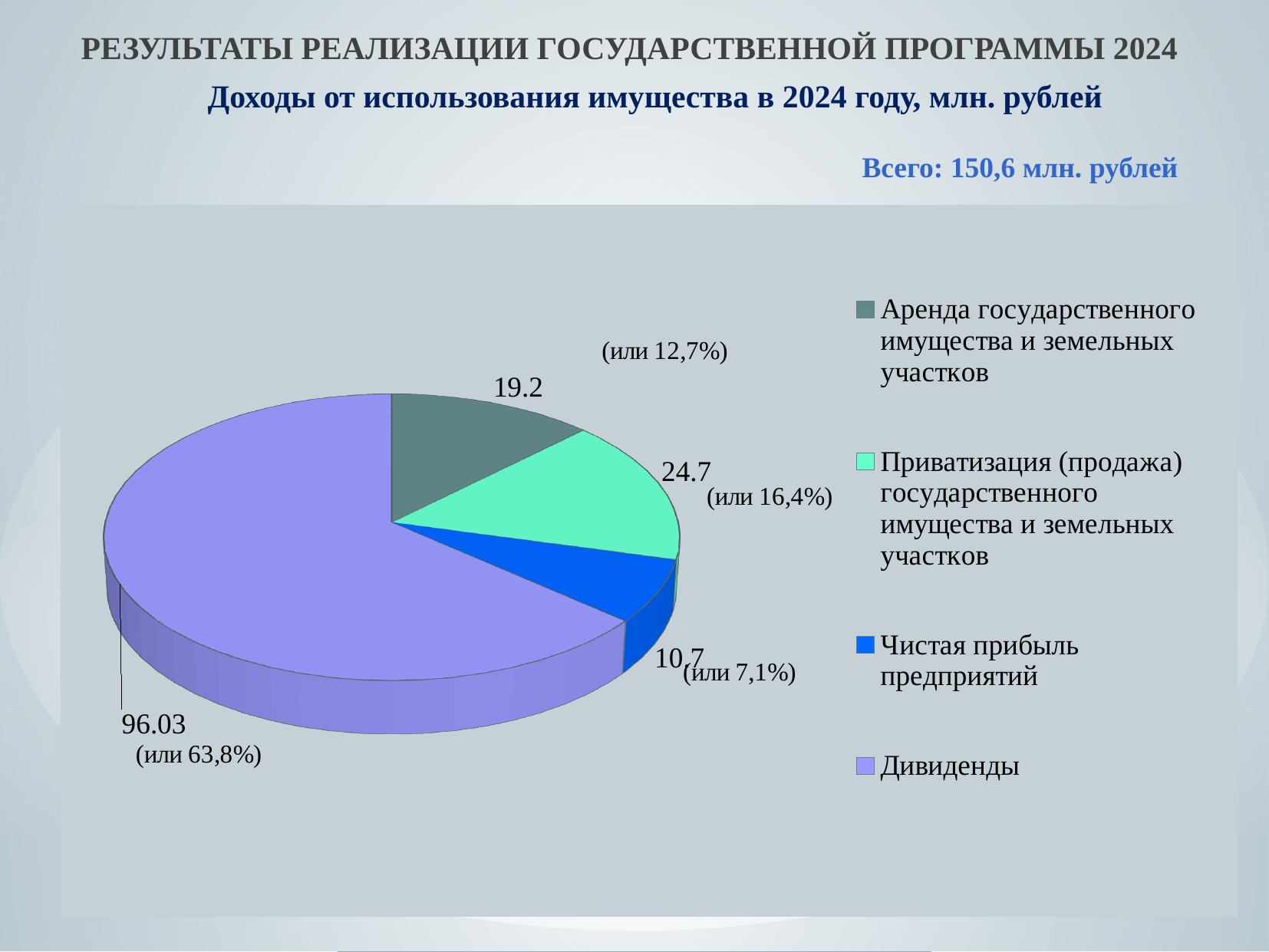
What is the value for Чистая прибыль предприятий? 10.7 Which category has the largest slice of the pie? Дивиденды Which category has the smallest slice of the pie? Чистая прибыль предприятий What is the difference between the values for Приватизация and Аренда государственного имущества? 5.5 What is the value for Аренда государственного имущества и земельных участков? 19.2 What type of chart is shown on the slide? Pie chart What is the value for Дивиденды? 96.03 What share of the pie does Дивиденды represent? 63,8% How many categories does the legend list? 4 What is the value for Приватизация (продажа) государственного имущества и земельных участков? 24.7 Which is larger, the value for Аренда государственного имущества or Чистая прибыль предприятий? Аренда государственного имущества и земельных участков What share of the pie does Чистая прибыль предприятий represent? 7,1%